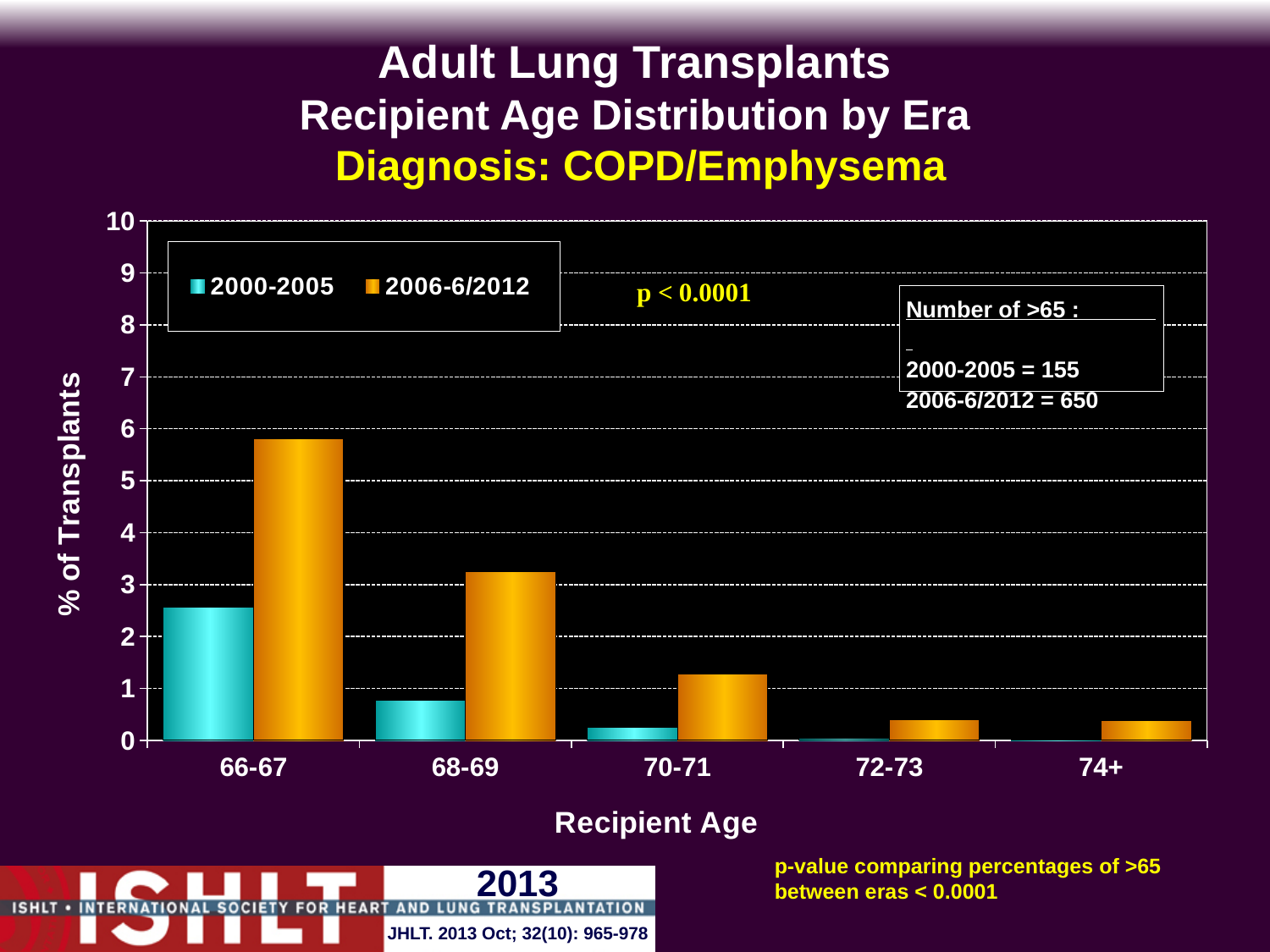
What kind of chart is shown on the slide? bar chart According to the text box on the chart, what is the number of >65 recipients for 2006-6/2012? 650 Is the value for 2006-6/2012 in the 68-69 age group greater or less than 3? greater How many series does the legend list? 2 Which recipient age category has the highest value for the 2006-6/2012 series? 66-67 What is the label of the y axis? % of Transplants Which recipient age category has the highest value for the 2000-2005 series? 66-67 Is the value for 2000-2005 in the 68-69 age group greater or less than 1? less Is the value for 2006-6/2012 in the 66-67 age group greater or less than 5? greater How many recipient age categories are shown on the x axis? 5 Do the values for the 2006-6/2012 series rise or fall as recipient age increases from 66-67 to 72-73? fall For the 66-67 age group, which series has the larger value, 2000-2005 or 2006-6/2012? 2006-6/2012